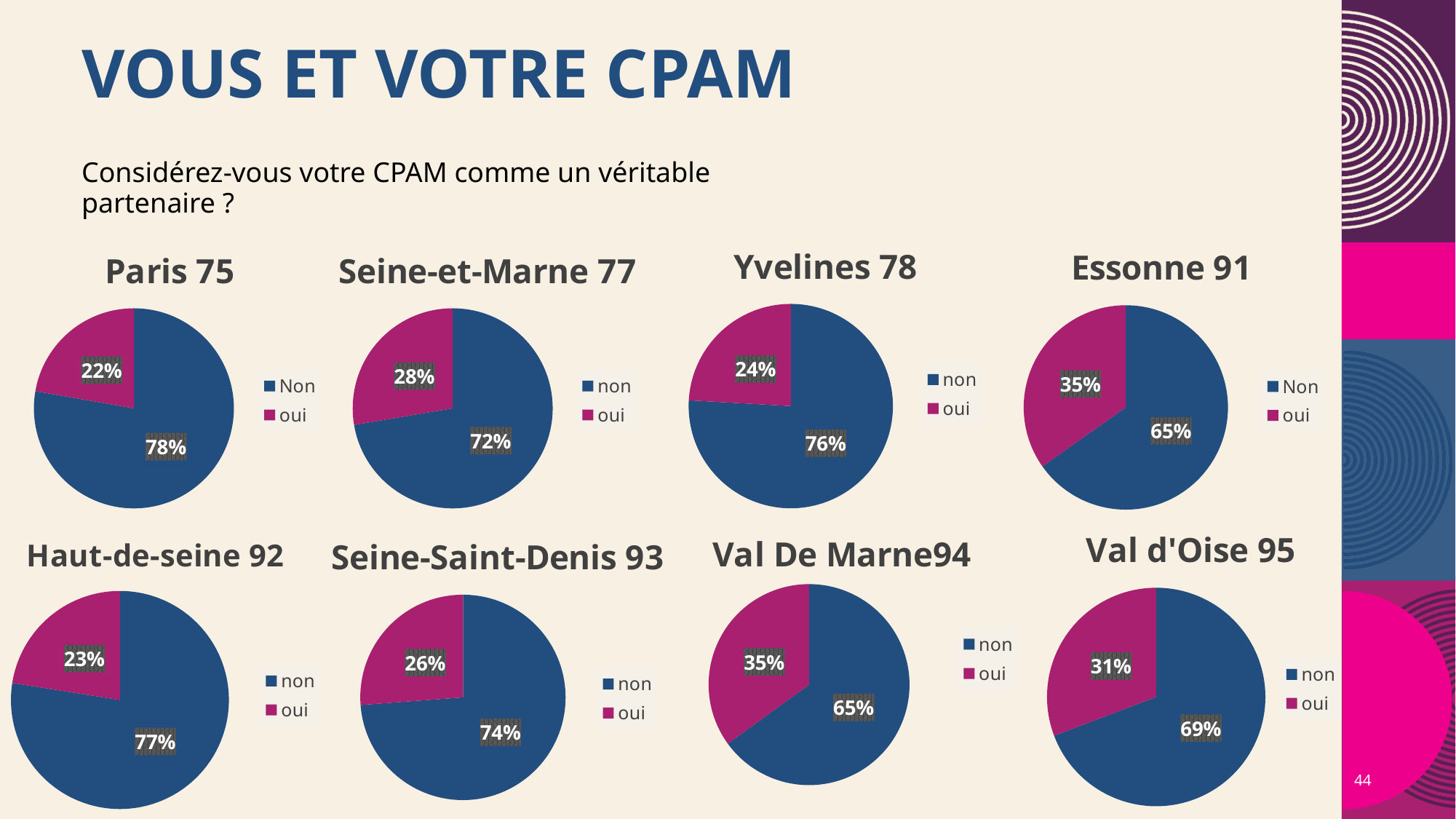
In the Seine-et-Marne 77 chart, what is the value for "non"? 72% How many pie charts are shown on the slide? 8 How many entries does the legend of the Yvelines 78 chart list? 2 How many slices does the Essonne 91 pie chart have? 2 In the Paris 75 chart, what share of respondents answered "oui"? 22% What type of chart is used for Paris 75? Pie chart In the Yvelines 78 chart, what percentage answered "oui"? 24% In the Val d'Oise 95 chart, what share answered "oui"? 31% In the Essonne 91 chart, what is the value for "Non"? 65% In the Val De Marne94 chart, what is the difference between the "non" and "oui" shares? 30% In the Seine-Saint-Denis 93 chart, what is the difference between the "non" and "oui" shares? 48% In the Haut-de-seine 92 chart, which slice is larger, "non" or "oui"? non